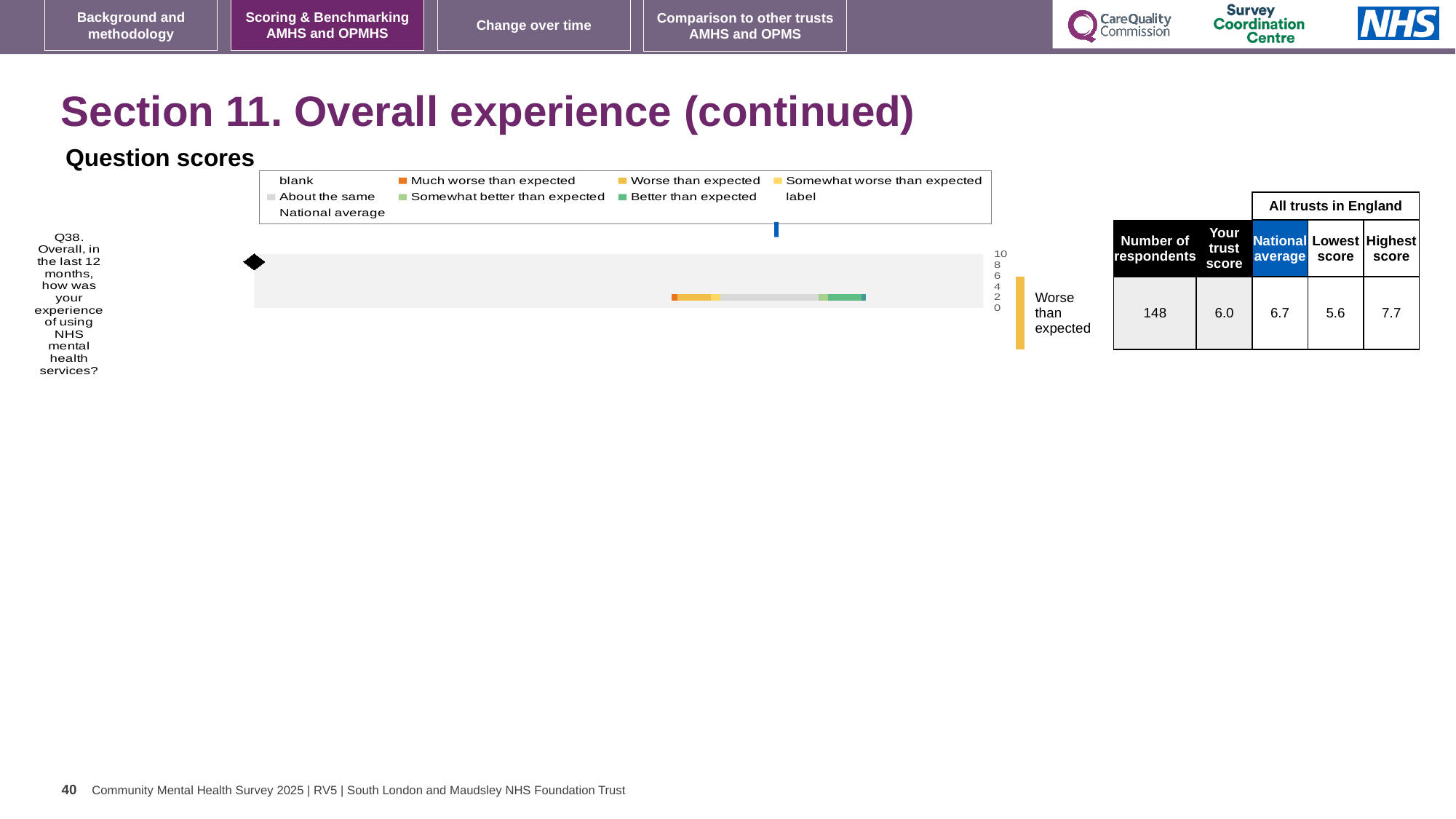
What is the difference between the highest and lowest scores among all trusts in England for Q38? 2.1 What is the highest score among all trusts in England for Q38? 7.7 What is the lowest score among all trusts in England for Q38? 5.6 What is the trust's score for Q38? 6.0 What benchmark category label is shown to the right of the Q38 bar? Worse than expected Which is larger for Q38, the trust score or the national average? national average What is the number of respondents for Q38 shown next to the chart? 148 What kind of chart is used to show the Q38 question score? bar chart What is the national average score for Q38? 6.7 How many questions are plotted in the Question scores chart? 1 What is the difference between the national average and the trust score for Q38? 0.7